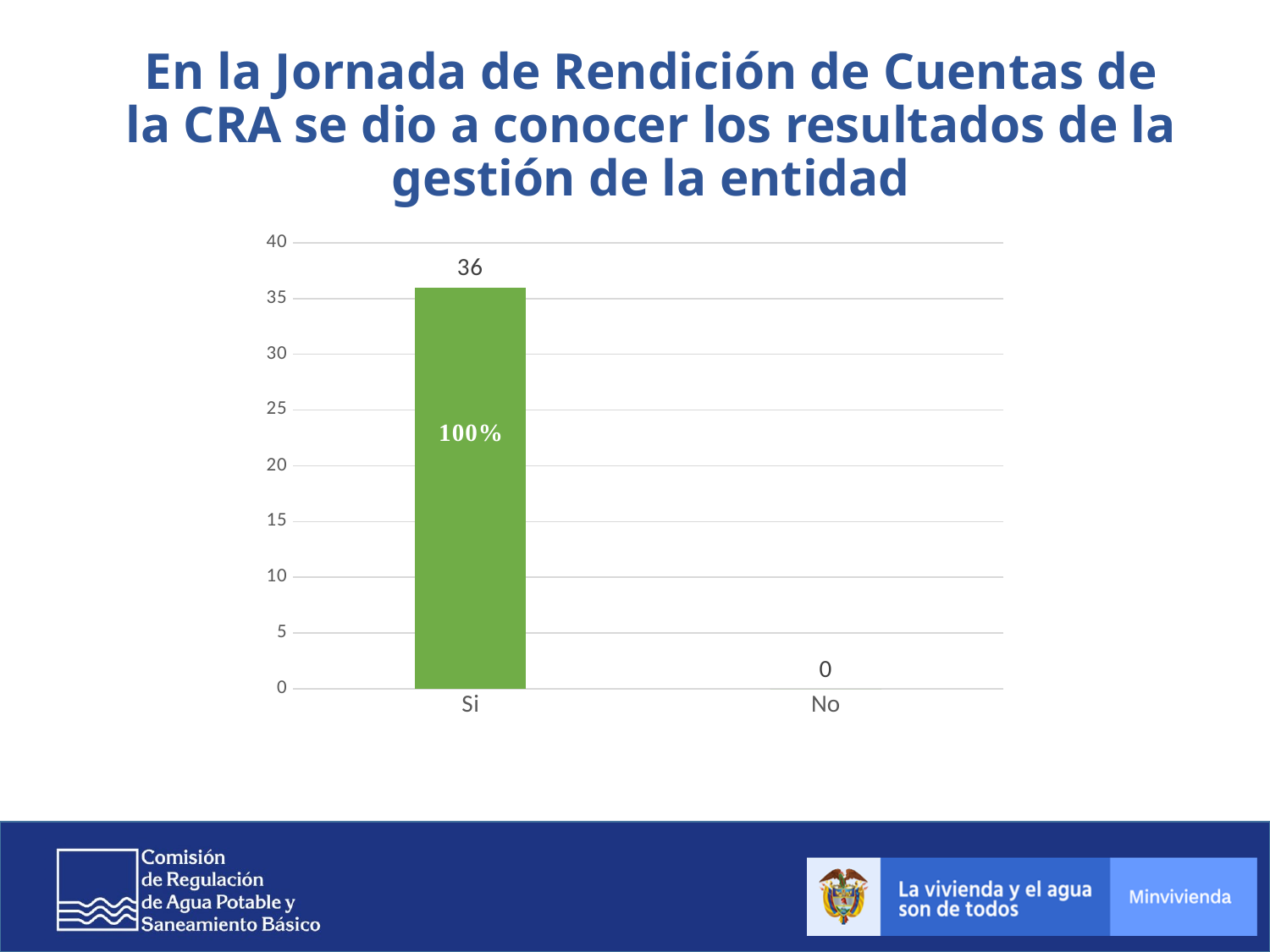
What is the total of the values for "Si" and "No"? 36 Which category has the lowest value? No Which category has the highest value? Si How many categories are shown on the x axis? 2 What is the difference between the values for "Si" and "No"? 36 What is the maximum value shown on the y axis? 40 Is the value for "Si" greater or less than 30? greater What is the value for "Si"? 36 What kind of chart is shown on the slide? bar chart Which is larger, the value for "Si" or the value for "No"? Si What is the value for "No"? 0 What percentage label is printed inside the "Si" bar? 100%